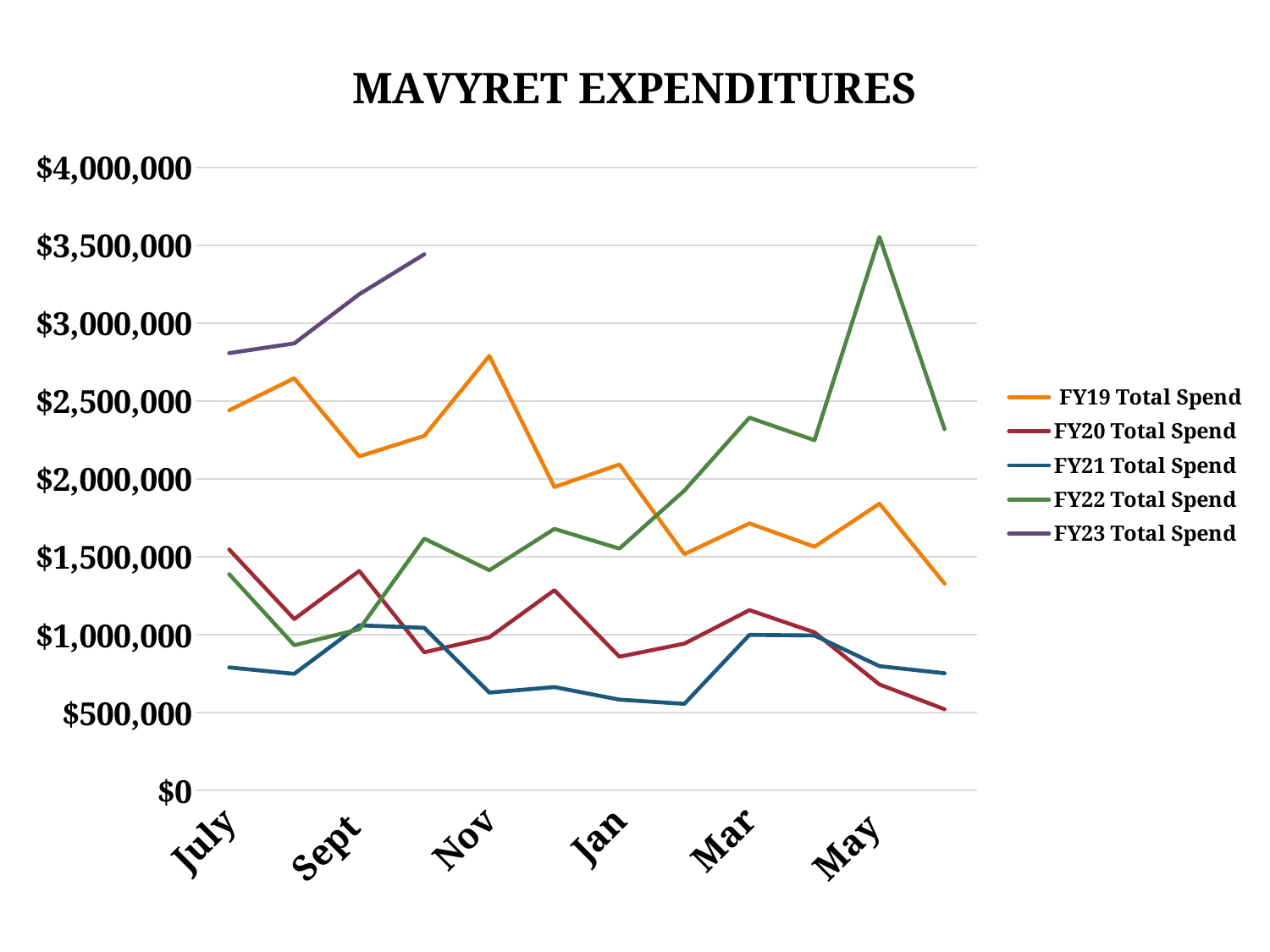
Is the value for FY21 Total Spend in Nov greater or less than $1,000,000? less Which series has the highest value in July? FY23 Total Spend Is the value for FY22 Total Spend in May greater or less than $3,000,000? greater Is the value for FY19 Total Spend in July greater or less than $2,000,000? greater What kind of chart is shown on the slide? line chart In July, which is larger: FY19 Total Spend or FY22 Total Spend? FY19 Total Spend What is the title of the chart? MAVYRET EXPENDITURES How many series does the legend list? 5 In which labelled month does FY22 Total Spend reach its highest value? May In May, which is larger: FY22 Total Spend or FY19 Total Spend? FY22 Total Spend